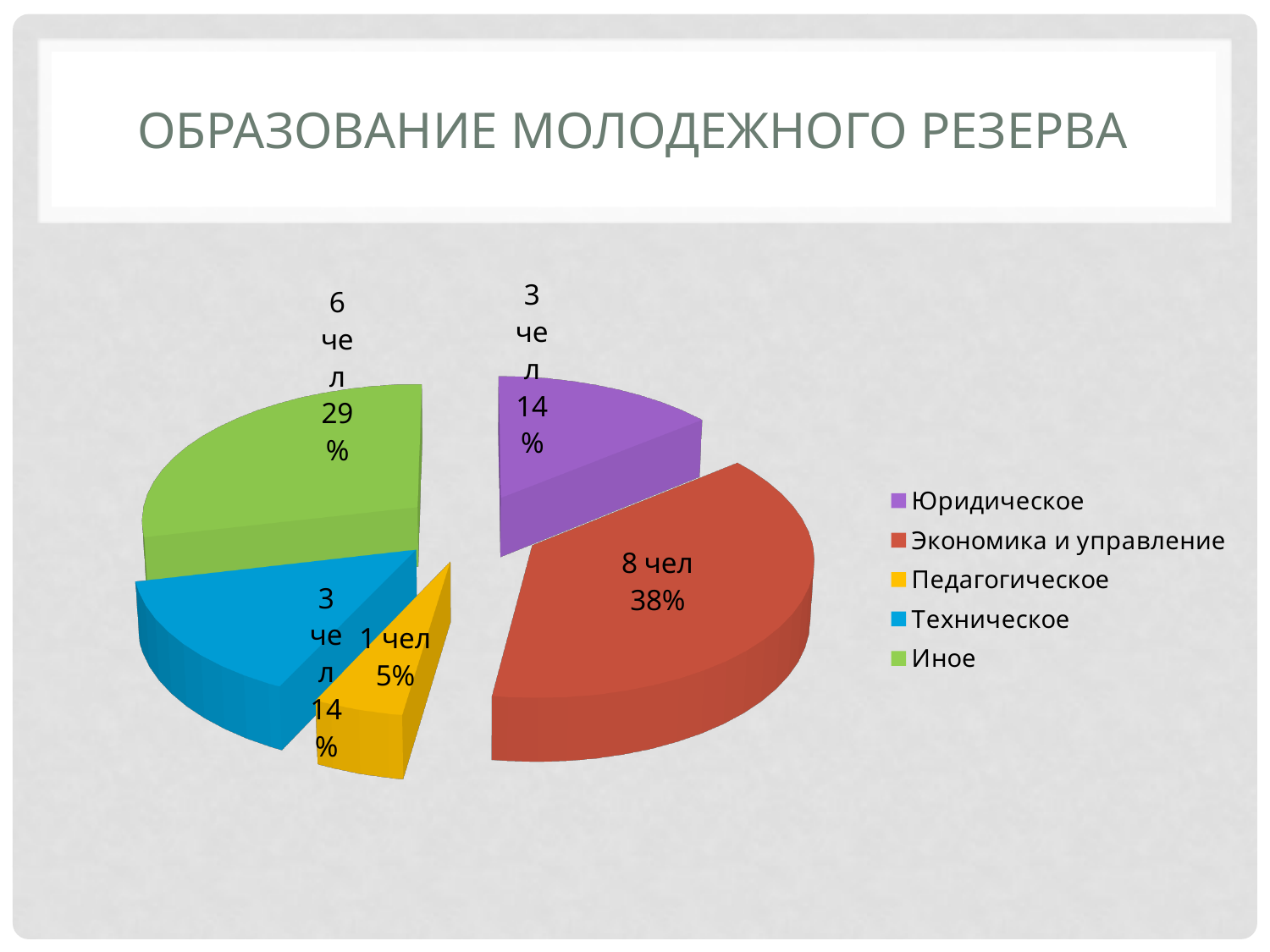
What is the difference in number of people between Экономика и управление and Иное? 2 чел What kind of chart is shown on the slide? pie chart What percentage share does the Юридическое slice have? 14% Which category has the smallest slice of the pie? Педагогическое Which category has the largest slice of the pie? Экономика и управление How many people are in the Иное slice? 6 чел What percentage share does the Педагогическое slice have? 5% Which is larger, the Иное slice or the Техническое slice? Иное How many categories does the pie chart have? 5 How many people are in the Экономика и управление slice? 8 чел What is the title of the chart slide? ОБРАЗОВАНИЕ МОЛОДЕЖНОГО РЕЗЕРВА What percentage share does the Иное slice have? 29%